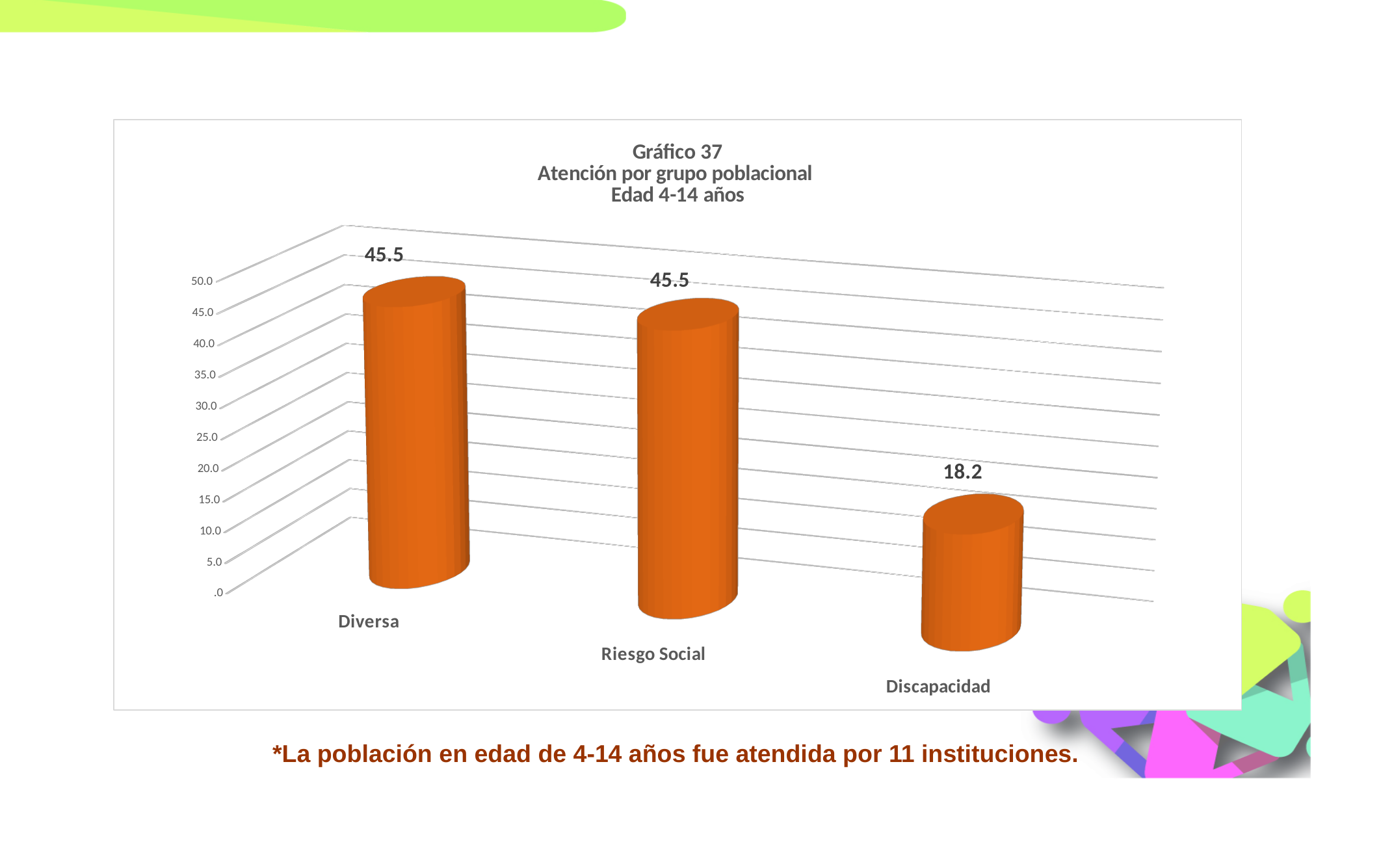
What kind of chart is shown on the slide? bar chart What age range is given in the chart title? 4-14 años What is the difference between the values for Diversa and Discapacidad? 27.3 How many categories are shown in the chart? 3 Which category has the lowest value? Discapacidad Which is larger, the value for Riesgo Social or the value for Discapacidad? Riesgo Social What is the value for Riesgo Social? 45.5 Is the value for Discapacidad greater or less than 20.0? less Is the value for Diversa greater or less than 40.0? greater What is the value for Diversa? 45.5 What is the difference between the values for Riesgo Social and Discapacidad? 27.3 What is the value for Discapacidad? 18.2